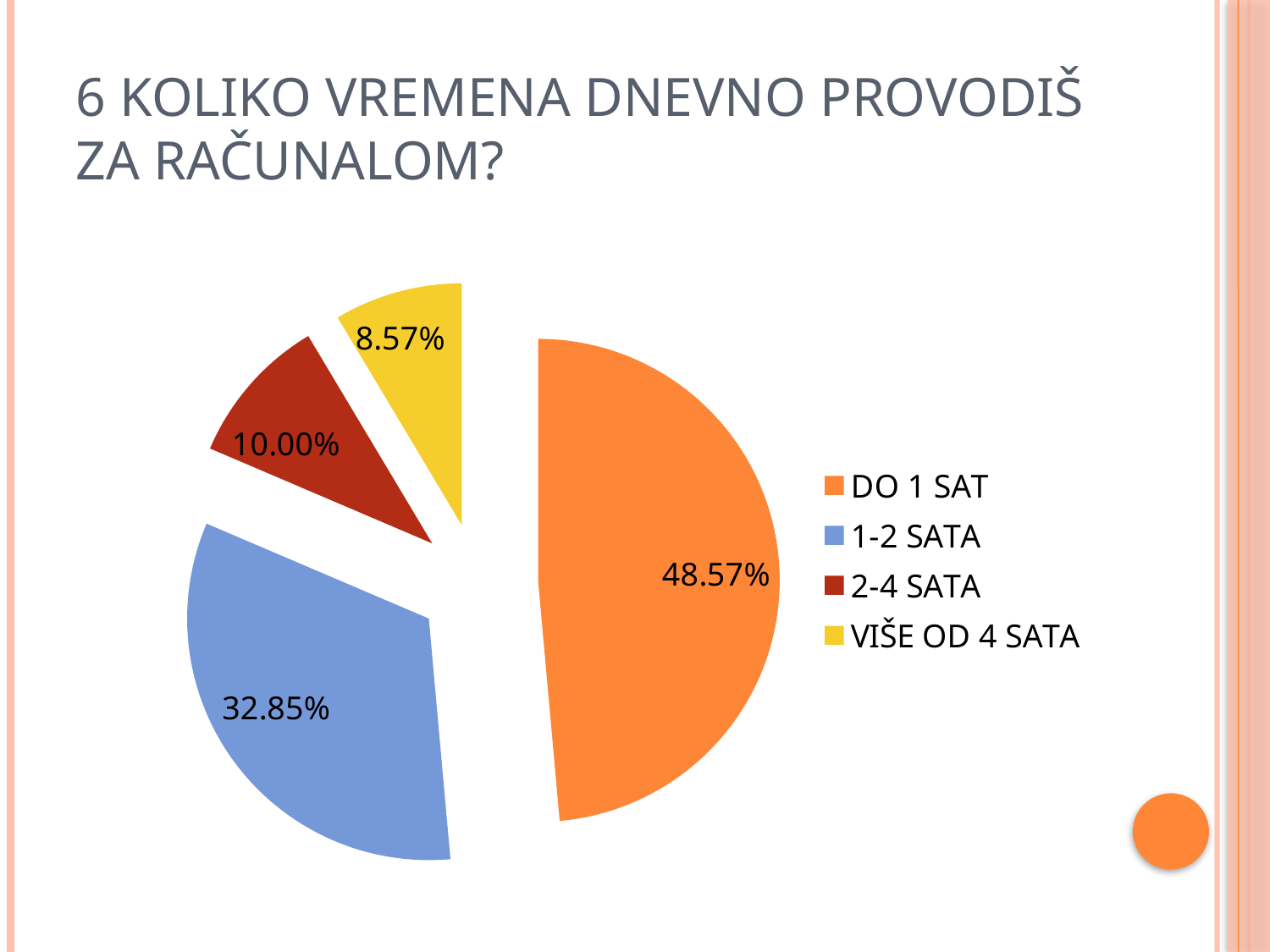
What share of the pie does the DO 1 SAT slice represent? 48.57% What is the value shown for VIŠE OD 4 SATA? 8.57% What is the value shown for 1-2 SATA? 32.85% Which legend entry is shown in yellow? VIŠE OD 4 SATA Which category has the largest slice of the pie? DO 1 SAT What is the value shown for 2-4 SATA? 10.00% Which category has the smallest slice of the pie? VIŠE OD 4 SATA What kind of chart is shown on the slide? pie chart How many categories does the pie chart have? 4 What is the difference in percentage points between DO 1 SAT and 1-2 SATA? 15.72 Which is larger, the slice for 2-4 SATA or the slice for VIŠE OD 4 SATA? 2-4 SATA What colour is the slice for 1-2 SATA? blue